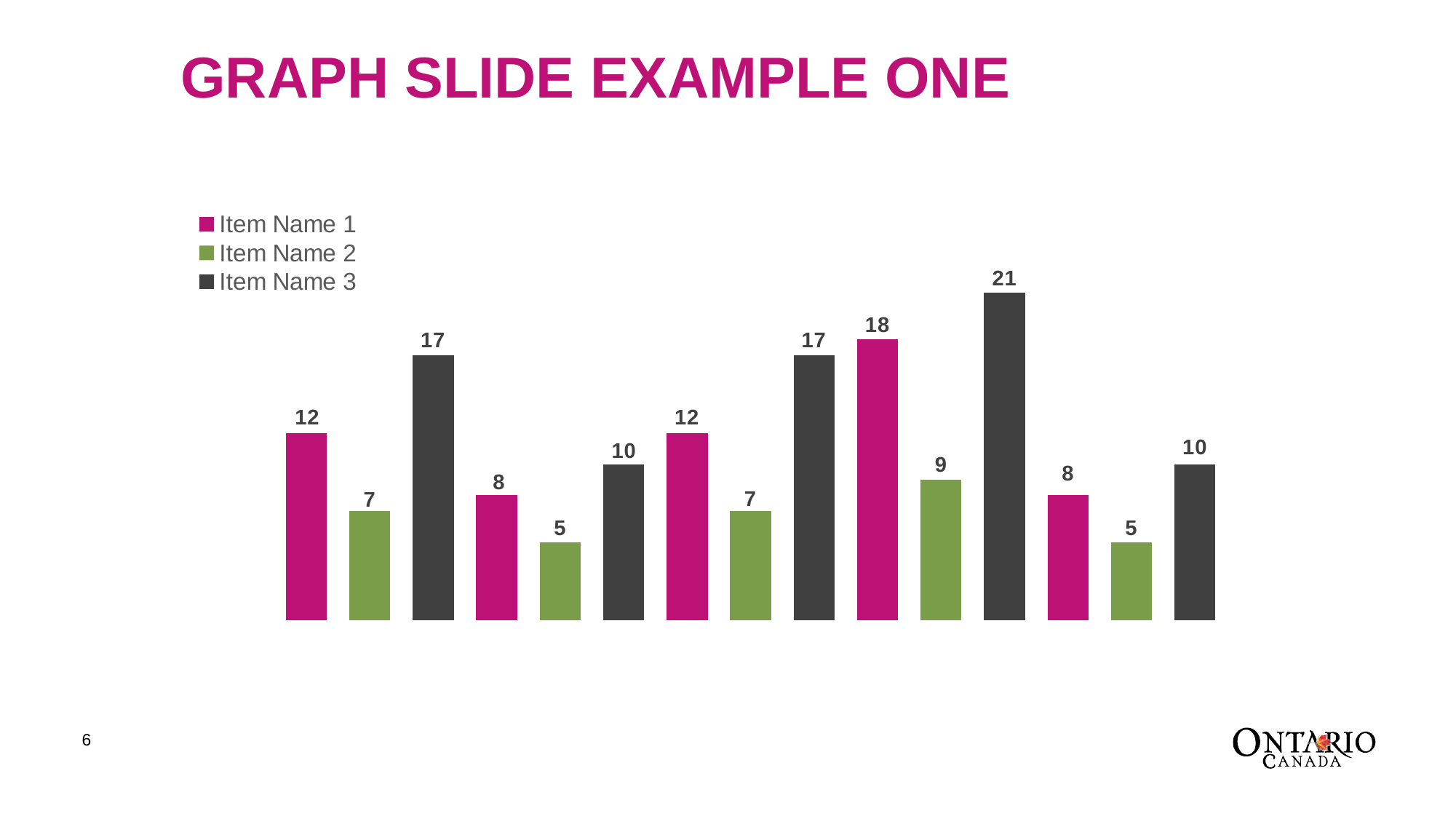
In the second group of bars, which is larger, the Item Name 1 value or the Item Name 3 value? Item Name 3 What is the value of the Item Name 1 bar in the first group of bars? 12 In the fourth group of bars, what is the difference between the Item Name 3 value and the Item Name 1 value? 3 What kind of chart is shown on the slide? bar chart What is the lowest value shown in the chart? 5 What is the value of the Item Name 2 bar in the second group of bars? 5 How many series does the legend list? 3 How many groups of bars are plotted in the chart? 5 What is the highest value for Item Name 1 across all groups? 18 What colour are the Item Name 2 bars? green What is the value of the Item Name 3 bar in the fourth group of bars? 21 What is the highest value shown in the chart? 21